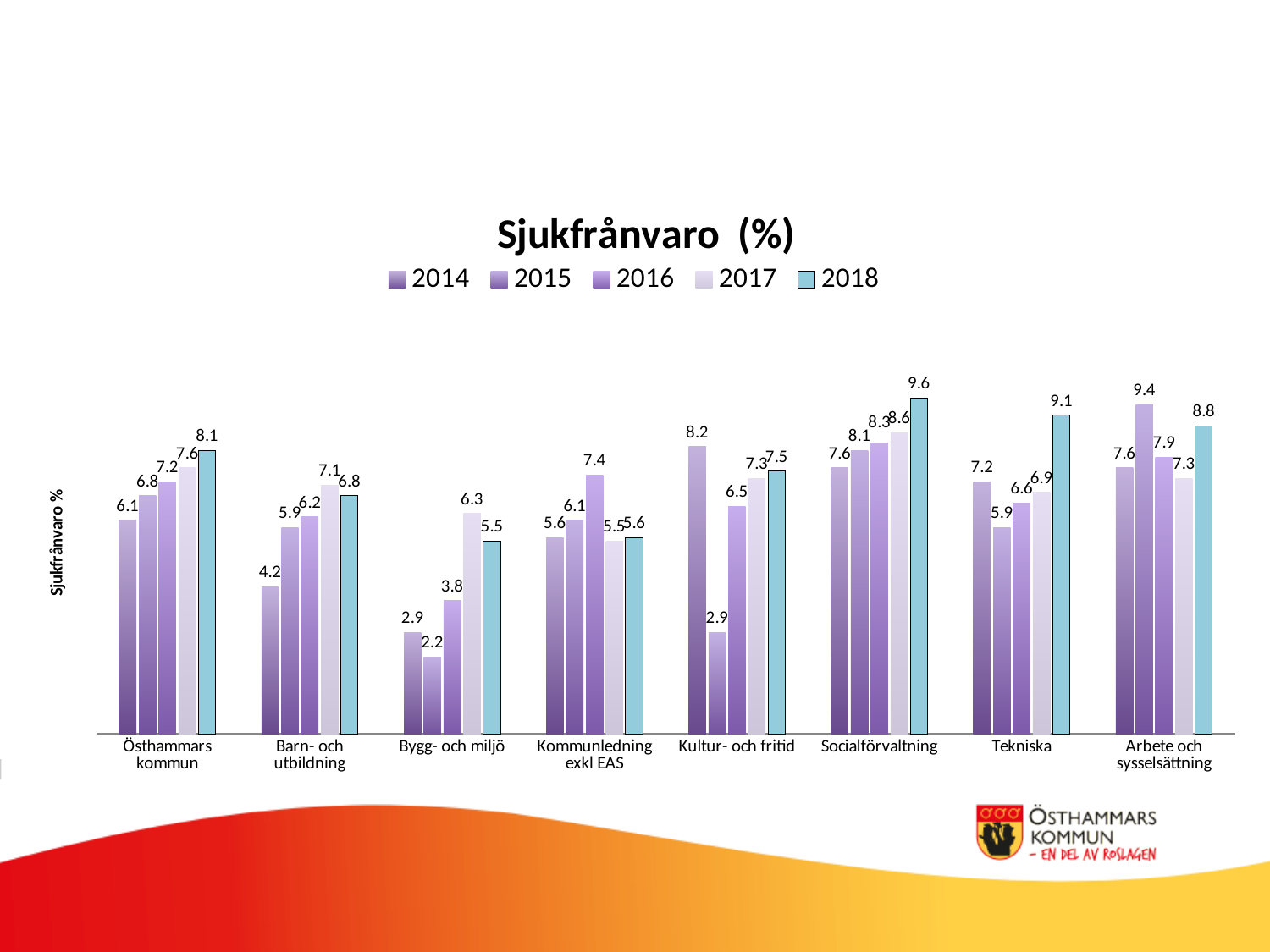
Which category has the highest value in 2018? Socialförvaltning What kind of chart is shown? Bar chart What is the value for Kultur- och fritid in 2014? 8.2 Do the values for Östhammars kommun rise or fall from 2014 to 2018? Rise Which is larger for Tekniska: the 2014 value or the 2018 value? 2018 Which category has the lowest value in 2015? Bygg- och miljö What is the difference between the 2018 and 2014 values for Östhammars kommun? 2.0 How many series does the legend list? 5 What is the title of the chart? Sjukfrånvaro (%) What is the value for Bygg- och miljö in 2015? 2.2 How many categories are shown on the x axis? 8 What is the value for Östhammars kommun in 2018? 8.1